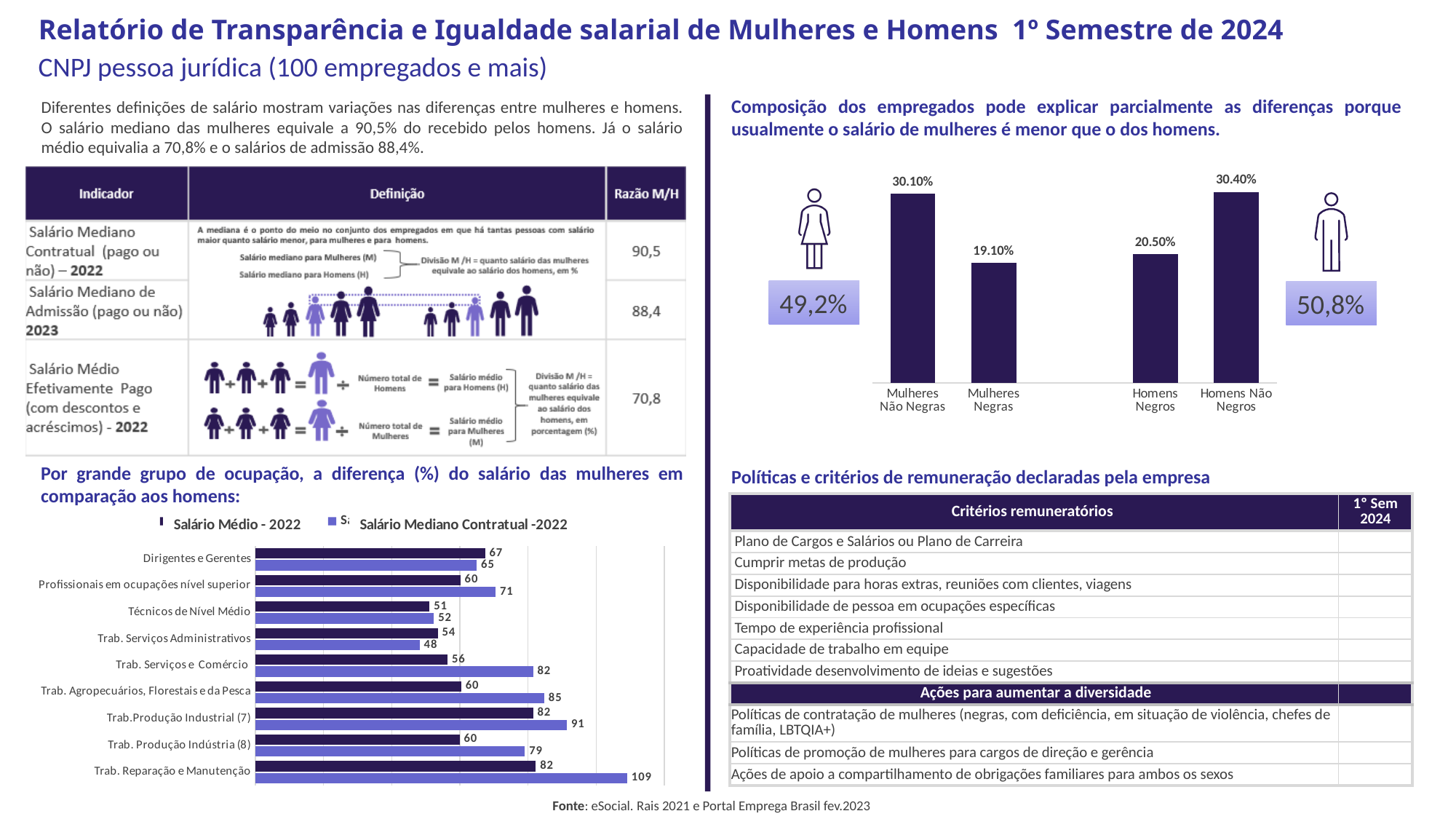
In the bottom-left chart 'Por grande grupo de ocupação', what is the Salário Médio - 2022 value for Dirigentes e Gerentes? 67 In the bottom-left chart 'Por grande grupo de ocupação', how many series does the legend list? 2 In the bottom-left chart 'Por grande grupo de ocupação', which occupation group has the highest Salário Mediano Contratual - 2022 value? Trab. Reparação e Manutenção In the bottom-left chart 'Por grande grupo de ocupação', what is the difference between the Salário Mediano Contratual - 2022 and Salário Médio - 2022 values for Trab. Serviços e Comércio? 26 In the bar chart on the right showing the composition of employees, which category has the highest value? Homens Não Negros In the bottom-left chart 'Por grande grupo de ocupação', which occupation group has the lowest Salário Mediano Contratual - 2022 value? Trab. Serviços Administrativos In the bar chart on the right showing the composition of employees, what is the difference between Homens Negros and Mulheres Negras? 1.40% In the bottom-left chart 'Por grande grupo de ocupação', what is the Salário Mediano Contratual - 2022 value for Trab. Reparação e Manutenção? 109 In the bar chart on the right showing the composition of employees, what is the value for Mulheres Negras? 19.10% In the bar chart on the right showing the composition of employees, how many categories are plotted? 4 In the bar chart on the right showing the composition of employees, which category has the lowest value? Mulheres Negras What type of chart is the bottom-left chart 'Por grande grupo de ocupação'? Bar chart